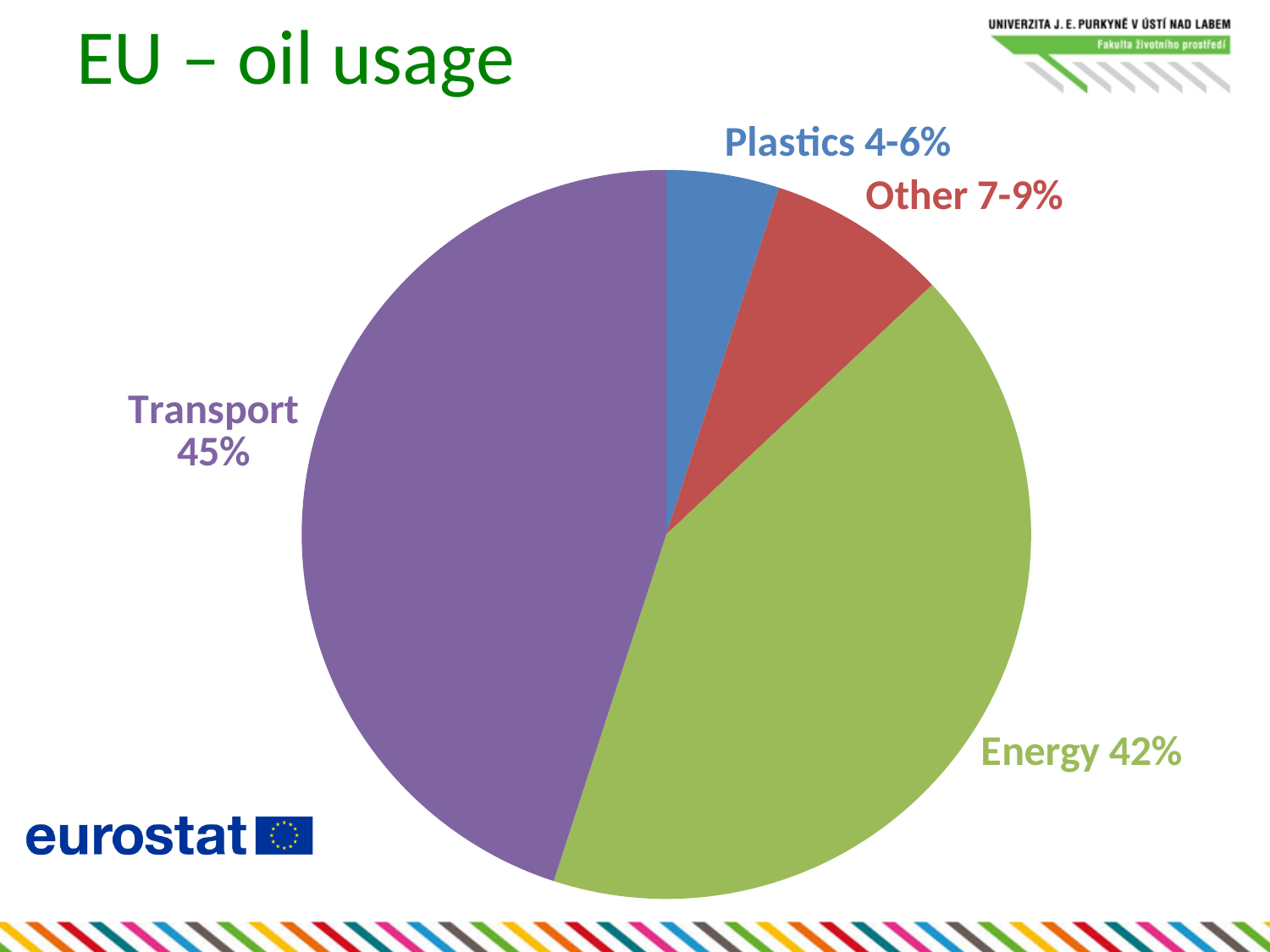
Which category has the smallest share of EU oil usage? Plastics What share of EU oil usage goes to Transport? 45% Which category has the largest share of EU oil usage? Transport Which is larger, the share for Transport or the share for Energy? Transport What type of chart is shown on the slide? pie chart What share of EU oil usage goes to Energy? 42% What is the title of the slide's chart? EU – oil usage What colour is the Energy slice of the pie chart? green By how many percentage points does the Transport share exceed the Energy share? 3 What share of EU oil usage is labelled Other? 7-9% How many slices does the pie chart have? 4